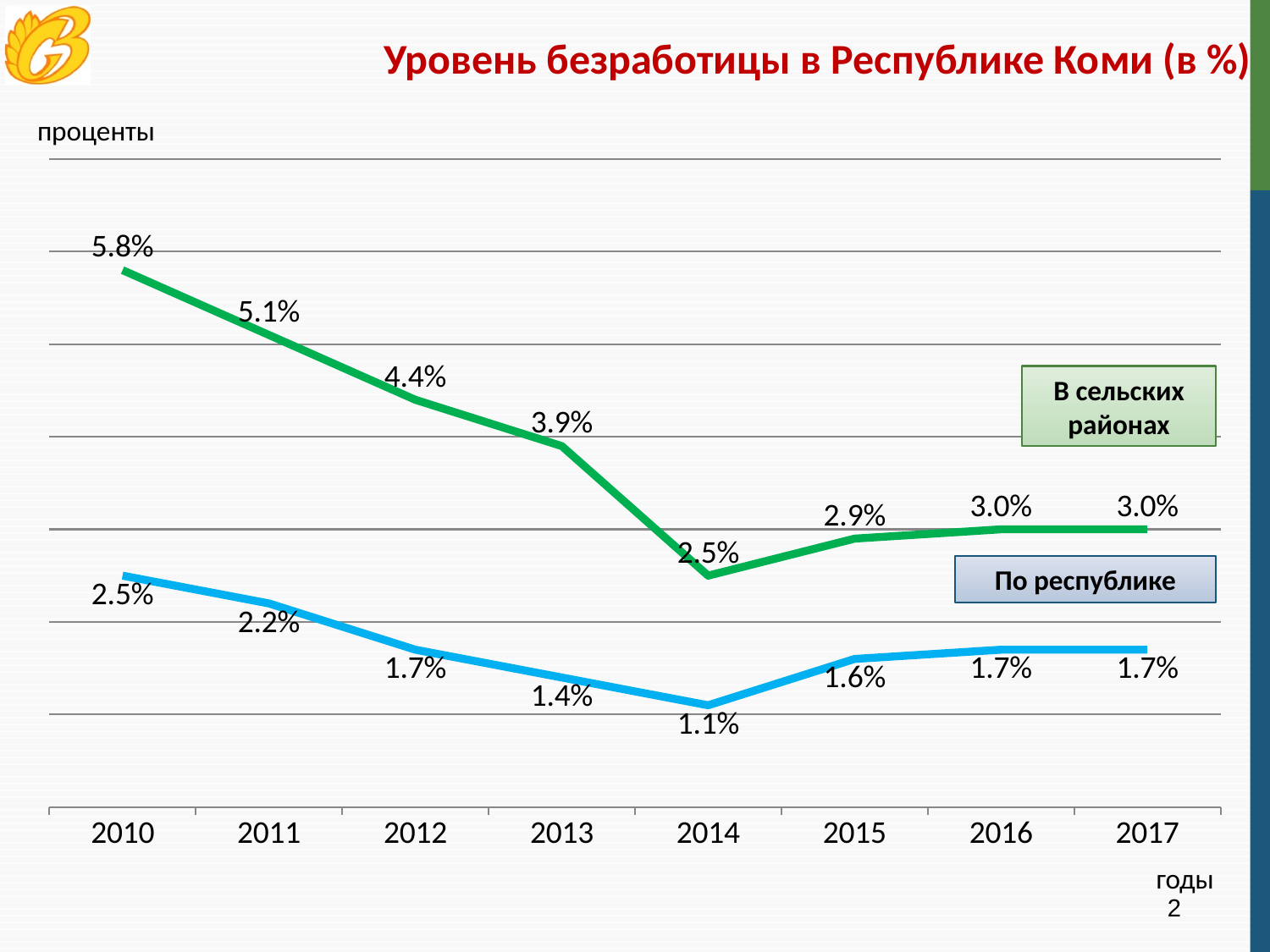
What type of chart is shown on the slide? line chart In which year was the unemployment rate for the republic (По республике) the highest? 2010 What was the unemployment rate for the republic (По республике) in 2012? 1.7% What is the difference between the rural (В сельских районах) and republic-wide (По республике) unemployment rates in 2013? 2.5% How many years are shown on the x axis? 8 Which was higher in 2011: the rural unemployment rate (В сельских районах) or the republic-wide rate (По республике)? В сельских районах How many series does the chart show? 2 What was the unemployment rate for the republic as a whole (По республике) in 2014? 1.1% What was the unemployment rate in rural areas (В сельских районах) in 2015? 2.9% How did the rural unemployment rate (В сельских районах) change from 2010 to 2014? It fell What was the unemployment rate in rural areas (В сельских районах) in 2010? 5.8% In which year was the unemployment rate in rural areas (В сельских районах) the lowest? 2014